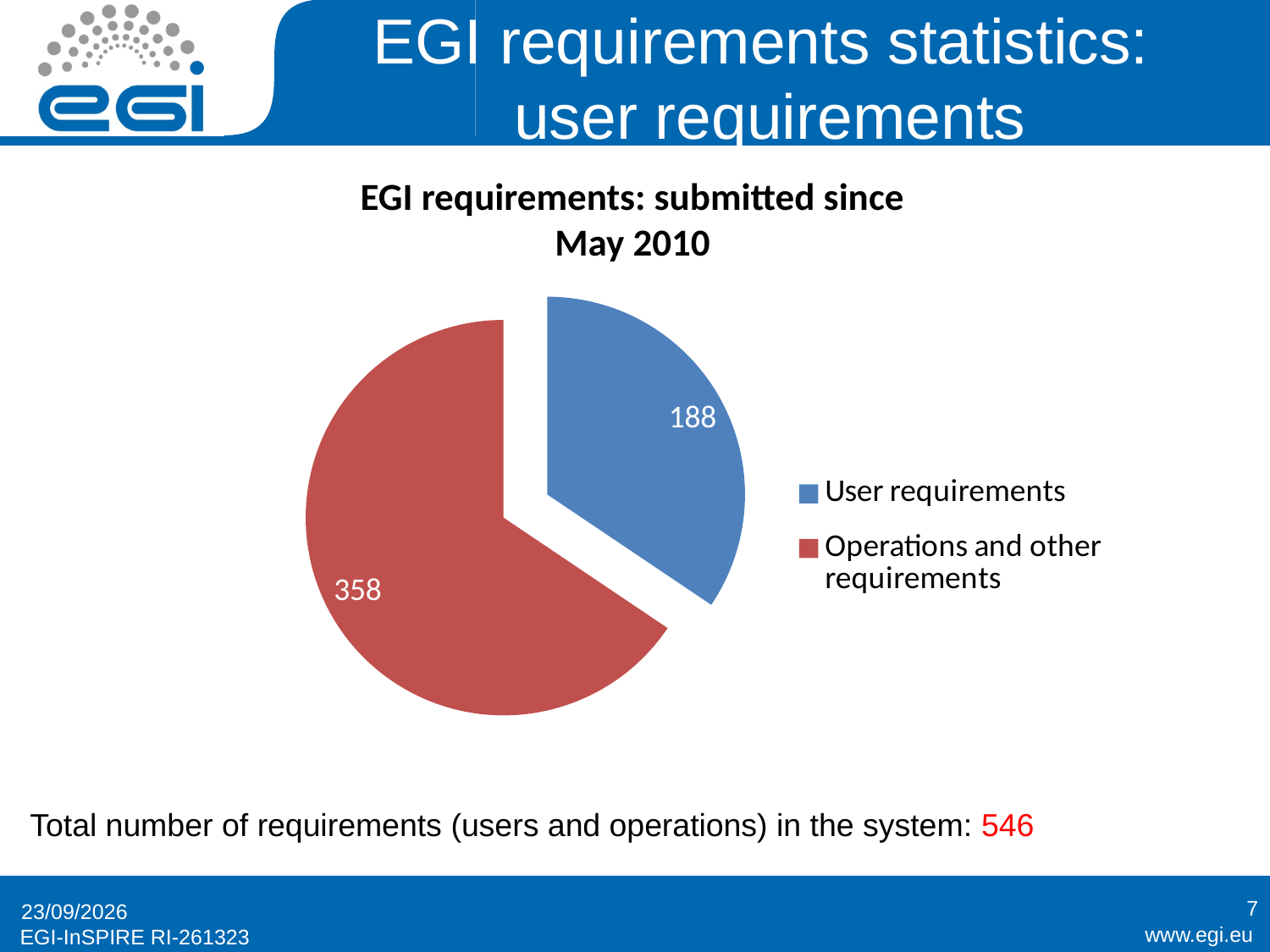
What is the difference between Operations and other requirements and User requirements? 170 Which category has the largest slice? Operations and other requirements What is the total of the two slices in the pie chart? 546 How many slices does the pie chart have? 2 Which category has the smallest slice? User requirements What is the value for User requirements? 188 Which is larger, User requirements or Operations and other requirements? Operations and other requirements What type of chart is shown on the slide? pie chart What is the title of the chart? EGI requirements: submitted since May 2010 What colour is the User requirements slice? blue What is the value for Operations and other requirements? 358